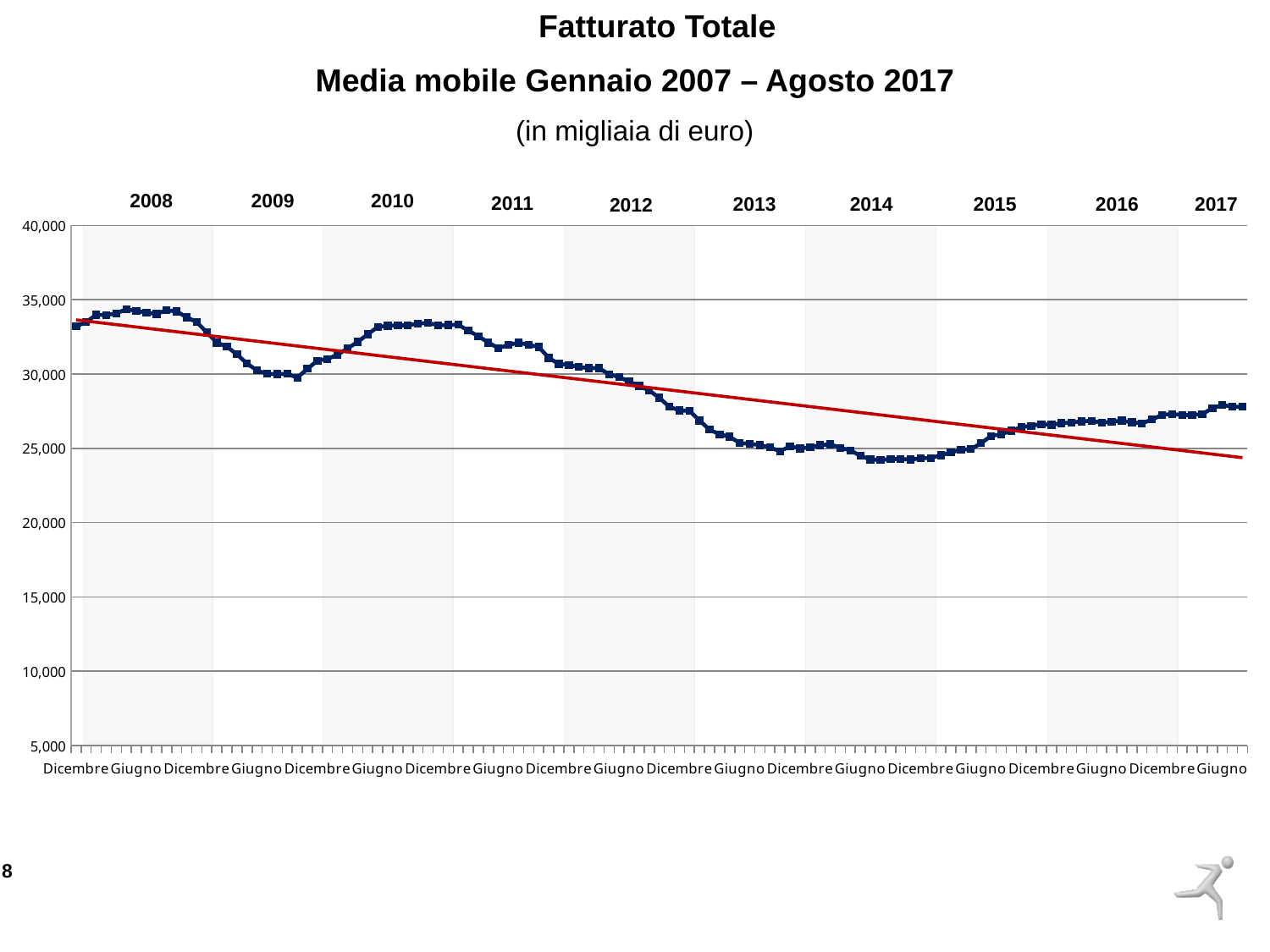
What kind of chart is shown on the slide? line chart In which labelled year does the moving average reach its lowest level? 2014 Which year shows higher moving average values, 2010 or 2013? 2010 Is the moving average value in mid-2008 greater or less than 30,000? greater Overall, does the moving average rise or fall from 2008 to 2017? fall Which year shows the highest moving average values, 2008 or 2014? 2008 Is the moving average value in 2010 greater or less than 30,000? greater What is the title of the chart? Fatturato Totale In what unit are the values on the chart expressed, according to the subtitle? migliaia di euro Is the moving average value in 2014 greater or less than 30,000? less How many year labels are shown along the top of the chart? 10